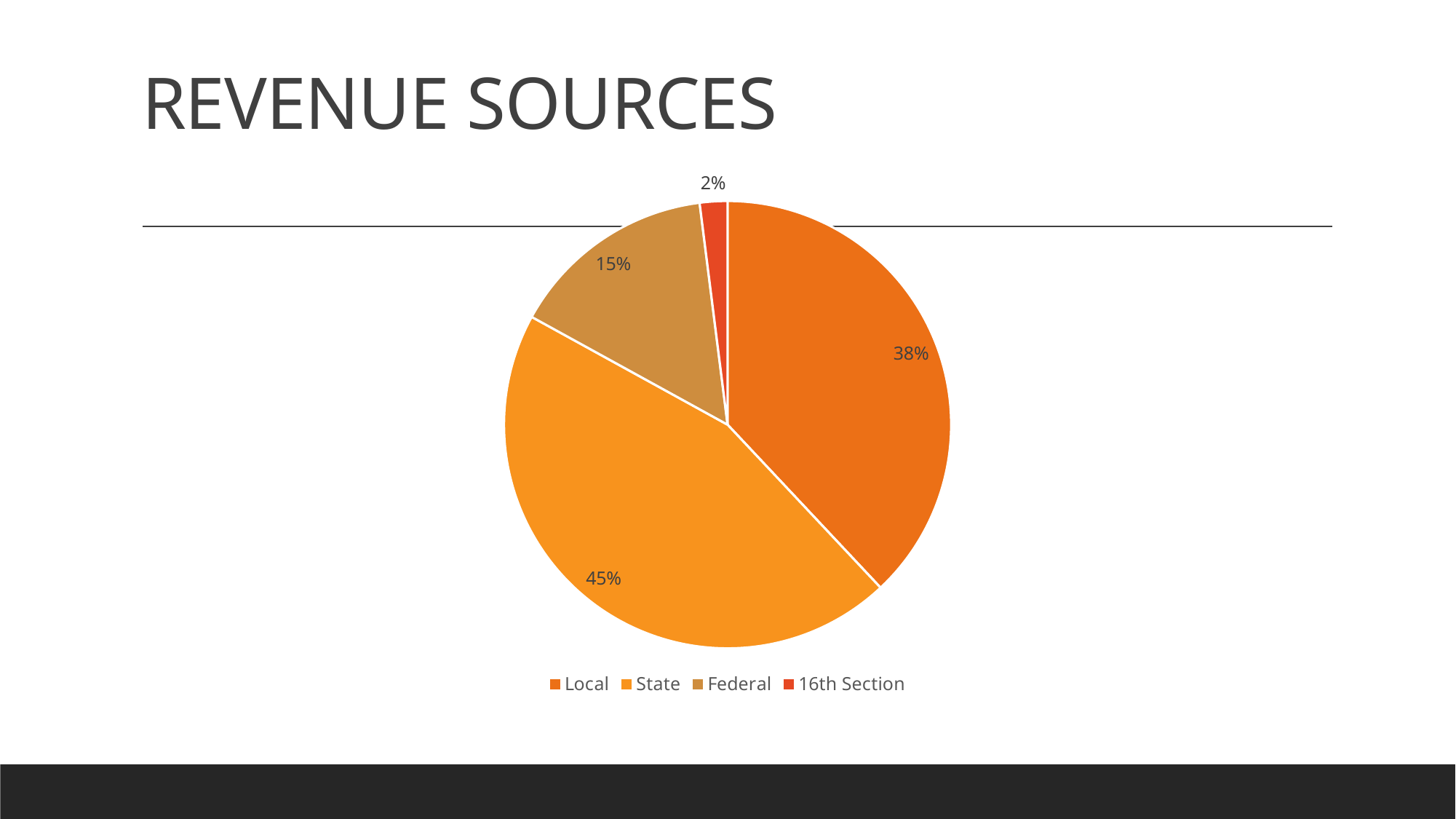
Which revenue source has the largest share? State How many revenue sources are shown in the pie chart? 4 Which revenue source has the smallest share? 16th Section What share of revenue comes from Local sources? 38% What is the title of the slide? REVENUE SOURCES What share of revenue comes from 16th Section? 2% What kind of chart is shown on the slide? pie chart What share of revenue comes from Federal sources? 15% What is the difference in percentage points between the State and Local shares? 7 What is the difference in percentage points between the Federal and 16th Section shares? 13 Which is larger, the Federal share or the Local share? Local